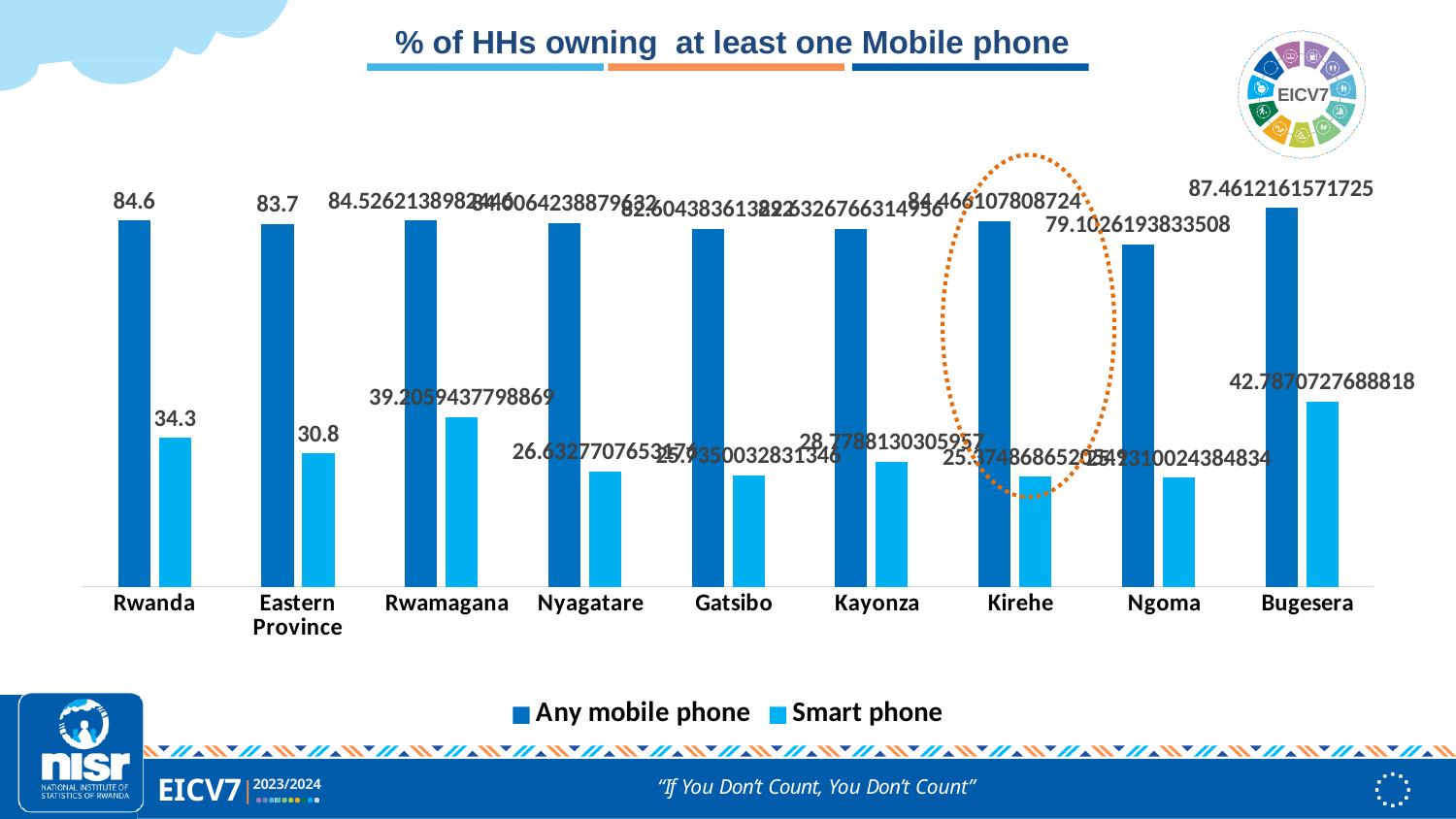
How many series does the legend list? 2 What is the value for Any mobile phone in Ngoma? 79.1026193833508 What is the value for Smart phone in Bugesera? 42.7870727688818 Which is larger, the Smart phone value for Rwanda or for Eastern Province? Rwanda Which category has the highest value for Any mobile phone? Bugesera Which category has the lowest value for Any mobile phone? Ngoma What is the value for Any mobile phone in Rwanda? 84.6 What kind of chart is shown on the slide? Bar chart What is the difference between the Any mobile phone and Smart phone values for Rwanda? 50.3 Which category has the highest value for Smart phone? Bugesera What is the value for Smart phone in Eastern Province? 30.8 How many categories are shown on the x axis? 9